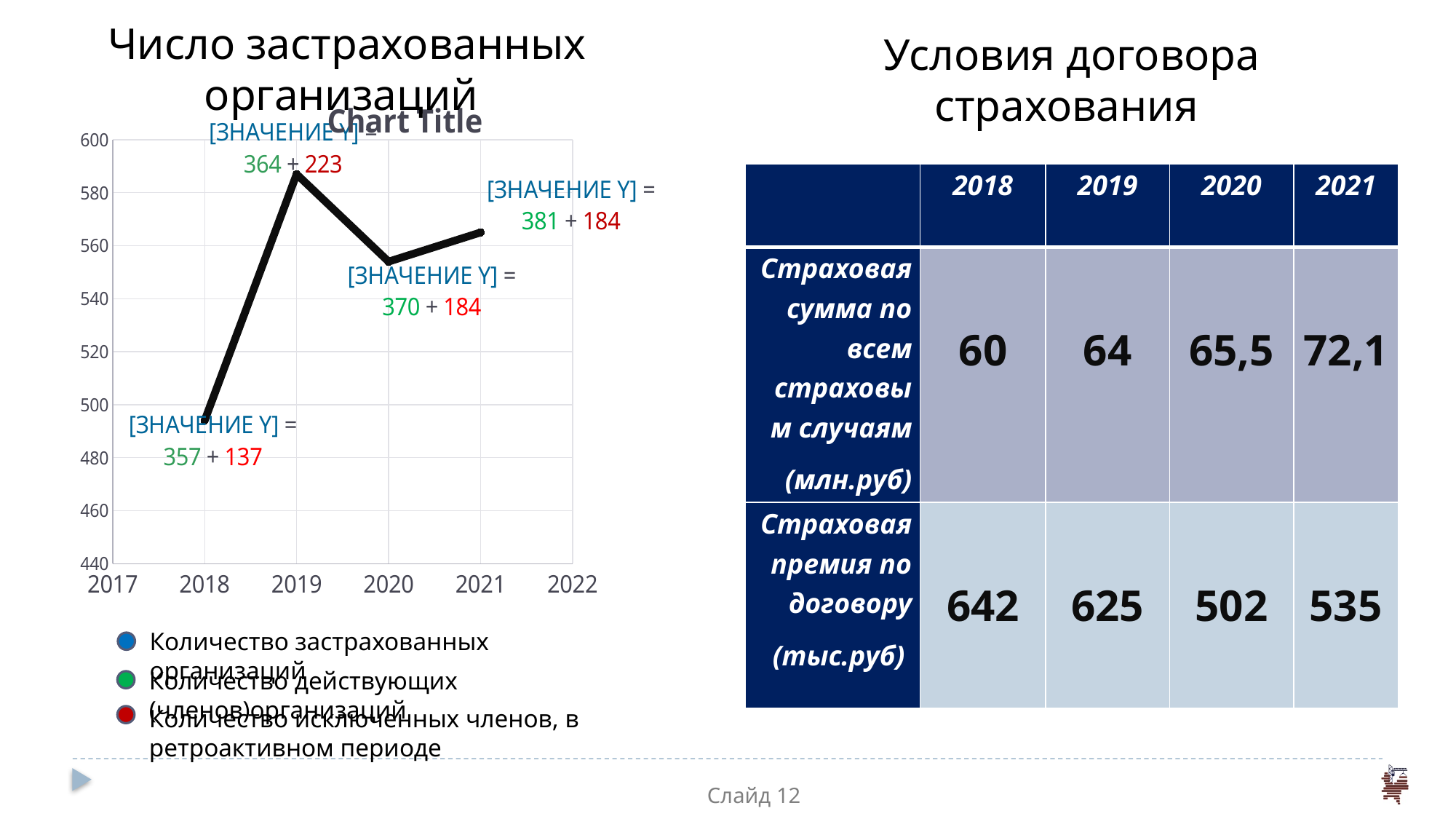
Is the plotted value for 2018 on the line chart greater or less than 500? less According to the data label on the line chart, what is the red number (количество исключенных членов) for 2019? 223 According to the data label on the line chart, what is the green number (количество действующих членов) for 2021? 381 In which year does the line chart reach its highest point? 2019 Is the plotted value for 2020 on the line chart greater or less than 560? less How many data points are plotted on the line chart? 4 Does the line on the chart rise or fall from 2019 to 2020? fall What kind of chart is shown under the title "Число застрахованных организаций"? line chart Is the plotted value for 2019 on the line chart greater or less than 580? greater How many entries does the legend of the line chart list? 3 In which year does the line chart reach its lowest point? 2018 On the line chart, what is the difference between the red number for 2019 (223) and the red number for 2018 (137)? 86